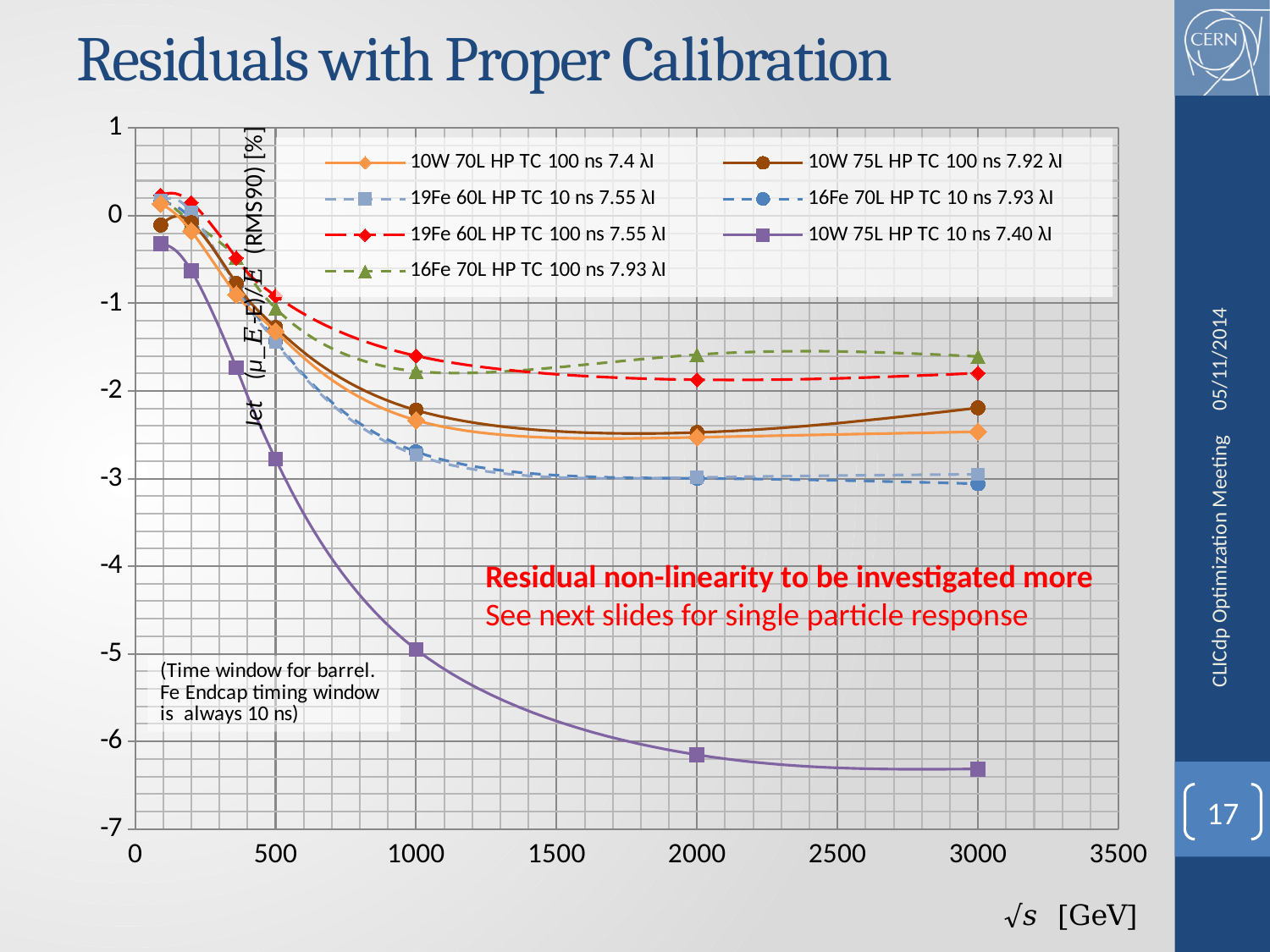
Is the value for 10W 70L HP TC 100 ns 7.4 λl at √s = 2000 GeV greater or less than -2? less How many series does the legend list? 7 Is the value for 16Fe 70L HP TC 100 ns 7.93 λl at √s = 3000 GeV greater or less than -2? greater Is the value for 10W 75L HP TC 10 ns 7.40 λl at √s = 3000 GeV greater or less than -6? less At √s = 3000 GeV, which series has the higher value: 10W 75L HP TC 100 ns 7.92 λl or 10W 70L HP TC 100 ns 7.4 λl? 10W 75L HP TC 100 ns 7.92 λl What is the label of the x axis of the chart? √s [GeV] Do the values for the 10W 75L HP TC 10 ns 7.40 λl series rise or fall as √s increases from 100 to 3000 GeV? fall What kind of chart is shown on the slide? line chart Which series has the lowest value at √s = 3000 GeV? 10W 75L HP TC 10 ns 7.40 λl At √s = 1000 GeV, which series has the higher value: 16Fe 70L HP TC 10 ns 7.93 λl or 10W 75L HP TC 10 ns 7.40 λl? 16Fe 70L HP TC 10 ns 7.93 λl Which series has the highest value at √s = 3000 GeV? 16Fe 70L HP TC 100 ns 7.93 λl